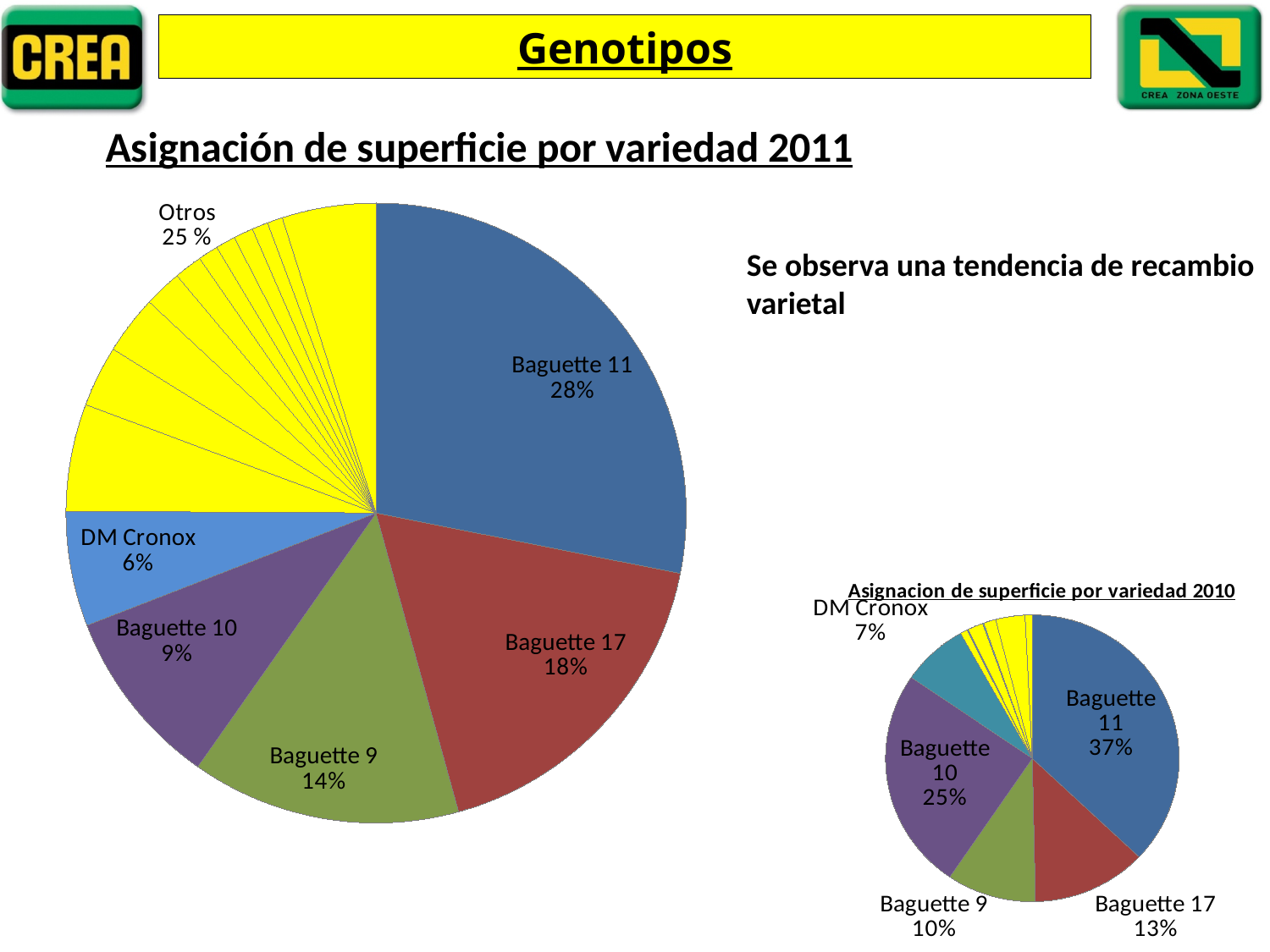
In the 2011 pie chart, what share does DM Cronox have? 6% In the 2011 pie chart, which is larger: the share of Baguette 9 or the share of Baguette 10? Baguette 9 In the 2011 pie chart, which labelled variety has the smallest share? DM Cronox In the 2010 pie chart (Asignacion de superficie por variedad 2010), what share does Baguette 11 have? 37% In the 2011 pie chart (Asignación de superficie por variedad 2011), what share does Baguette 11 have? 28% In the 2011 pie chart, what is the difference between the shares of Baguette 11 and Baguette 17? 10% What is the title of the smaller chart on the right of the slide? Asignacion de superficie por variedad 2010 In the 2011 pie chart, what share does Baguette 17 have? 18% In the 2010 pie chart, what is the difference between the shares of Baguette 10 and Baguette 9? 15% In the 2011 pie chart, which labelled variety has the largest share? Baguette 11 In the 2010 pie chart, what share does Baguette 10 have? 25% What type of chart is used for the 2011 variety distribution? Pie chart